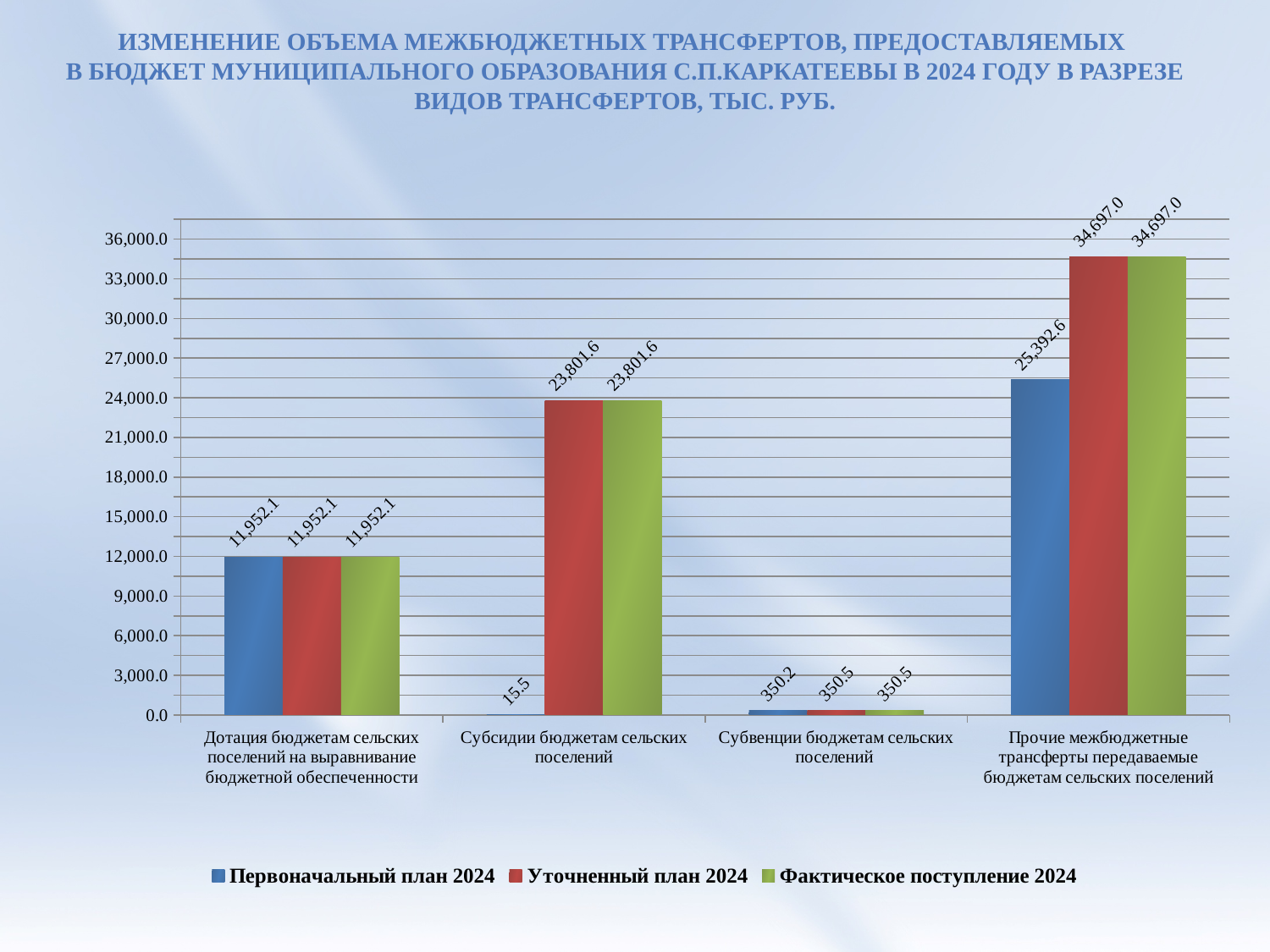
What is the value of Фактическое поступление 2024 for Дотация бюджетам сельских поселений на выравнивание бюджетной обеспеченности? 11,952.1 What is the value of Уточненный план 2024 for Прочие межбюджетные трансферты передаваемые бюджетам сельских поселений? 34,697.0 What is the value of Первоначальный план 2024 for Субсидии бюджетам сельских поселений? 15.5 Which is larger for Субсидии бюджетам сельских поселений: Первоначальный план 2024 or Уточненный план 2024? Уточненный план 2024 What is the value of Первоначальный план 2024 for Субвенции бюджетам сельских поселений? 350.2 How many categories are shown on the x axis? 4 What kind of chart is shown on the slide? bar chart Which category has the lowest value for Первоначальный план 2024? Субсидии бюджетам сельских поселений How many series does the legend list? 3 Which category has the highest value for Фактическое поступление 2024? Прочие межбюджетные трансферты передаваемые бюджетам сельских поселений What is the difference between Уточненный план 2024 and Первоначальный план 2024 for Прочие межбюджетные трансферты передаваемые бюджетам сельских поселений? 9,304.4 Is the value of Фактическое поступление 2024 for Субсидии бюджетам сельских поселений greater or less than 21,000.0? greater